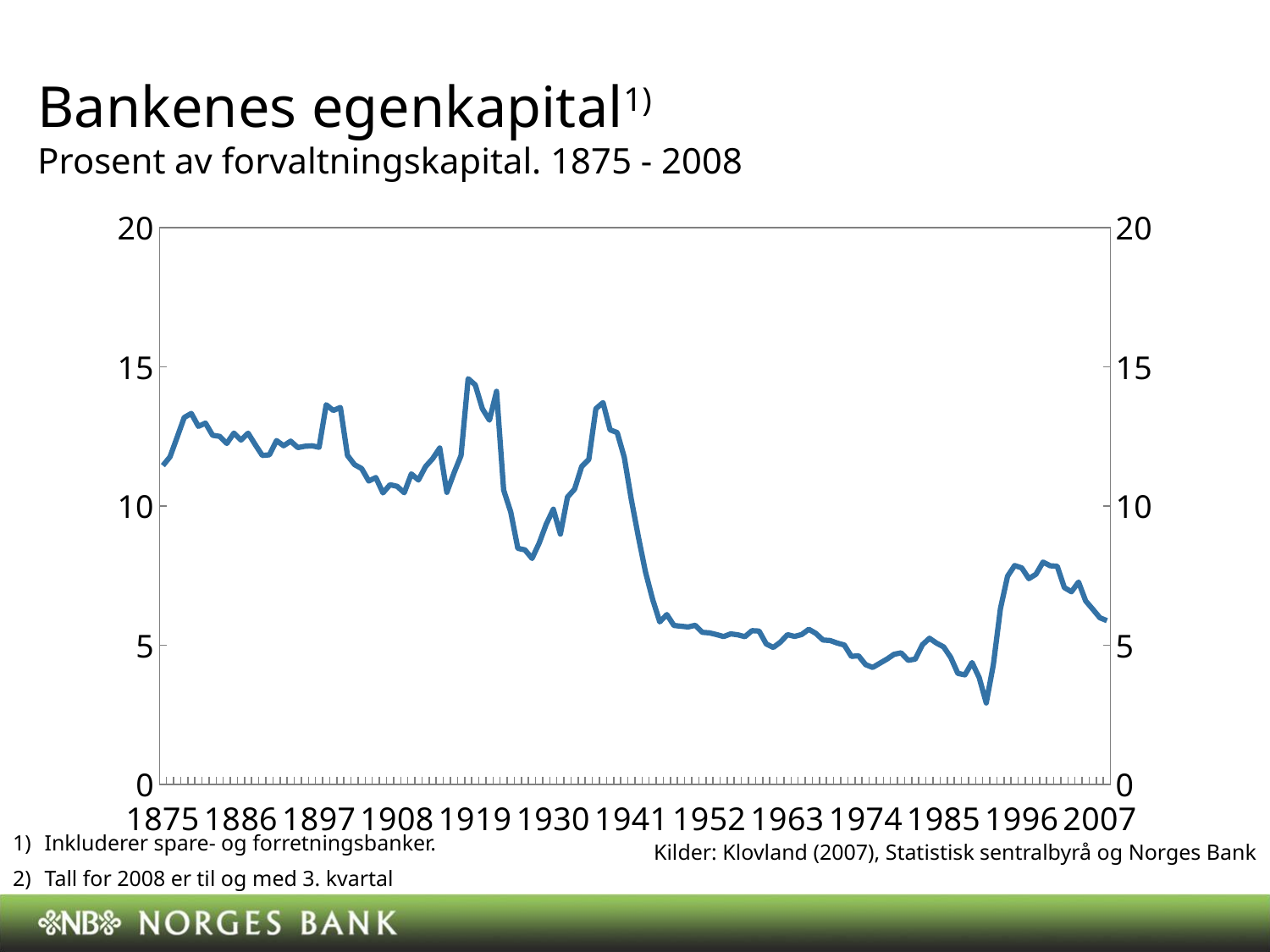
What is the title of the chart? Bankenes egenkapital Is the value for 1952 greater or less than 10? less What is the highest value shown on the y axis? 20 Is the value for 1919 greater or less than 10? greater Is the value for 1996 greater or less than 5? greater What kind of chart is shown on the slide? line chart Do the values rise or fall between 1941 and 1952? fall Overall, do the values rise or fall from 1875 to 2007? fall